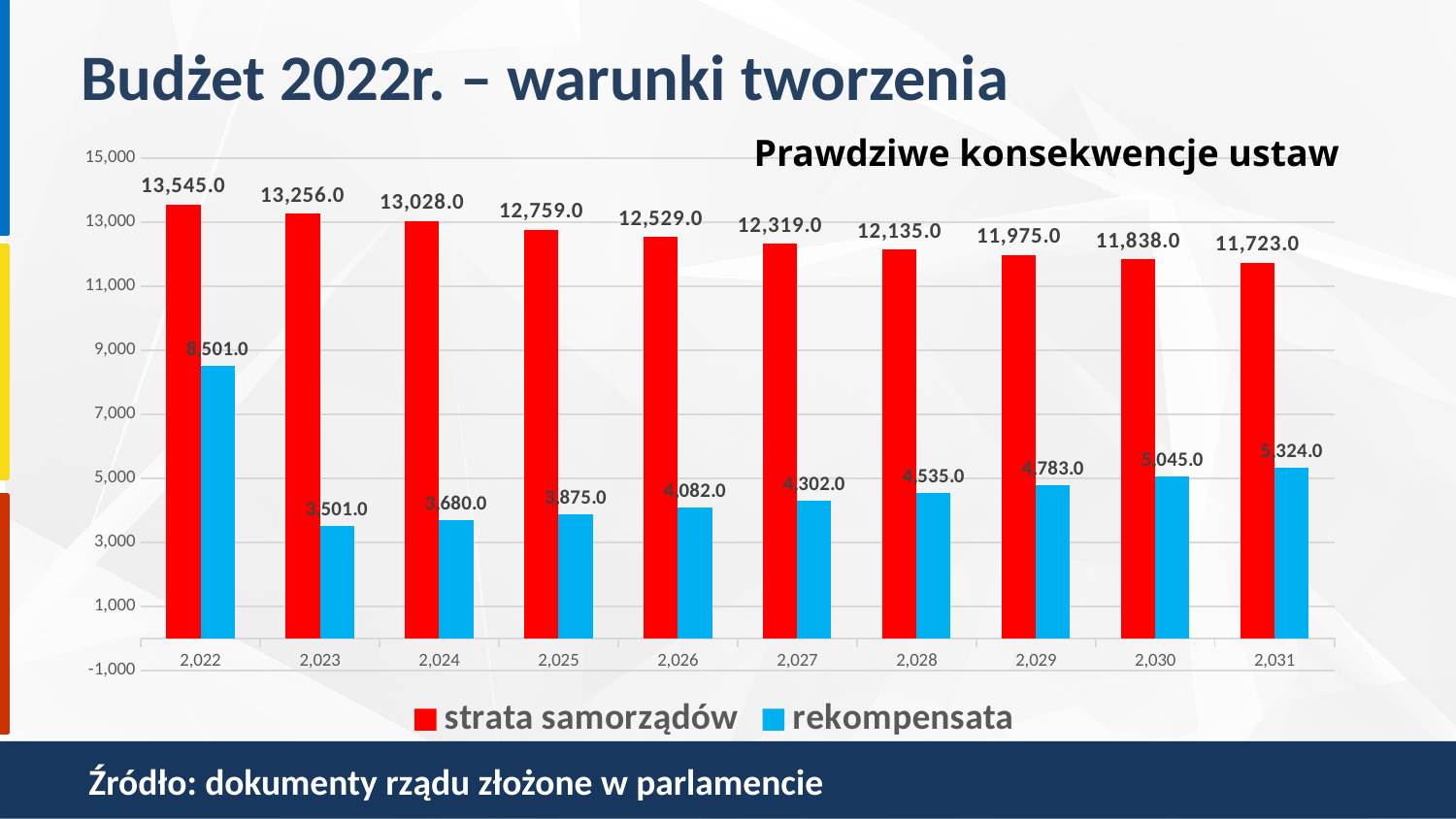
What is the value of 'strata samorządów' for 2,022? 13,545.0 How many years (categories) are shown on the x axis? 10 Which is larger in 2,028: 'strata samorządów' or 'rekompensata'? strata samorządów What is the value of 'rekompensata' for 2,031? 5,324.0 What is the difference between 'strata samorządów' and 'rekompensata' in 2,022? 5,044.0 In which year is 'strata samorządów' the lowest? 2,031 How many series does the legend list? 2 In which year is 'rekompensata' the highest? 2,022 What type of chart is shown on the slide? bar chart Does 'strata samorządów' rise or fall from 2,022 to 2,031? fall What colour are the 'rekompensata' bars? blue What is the value of 'rekompensata' for 2,026? 4,082.0